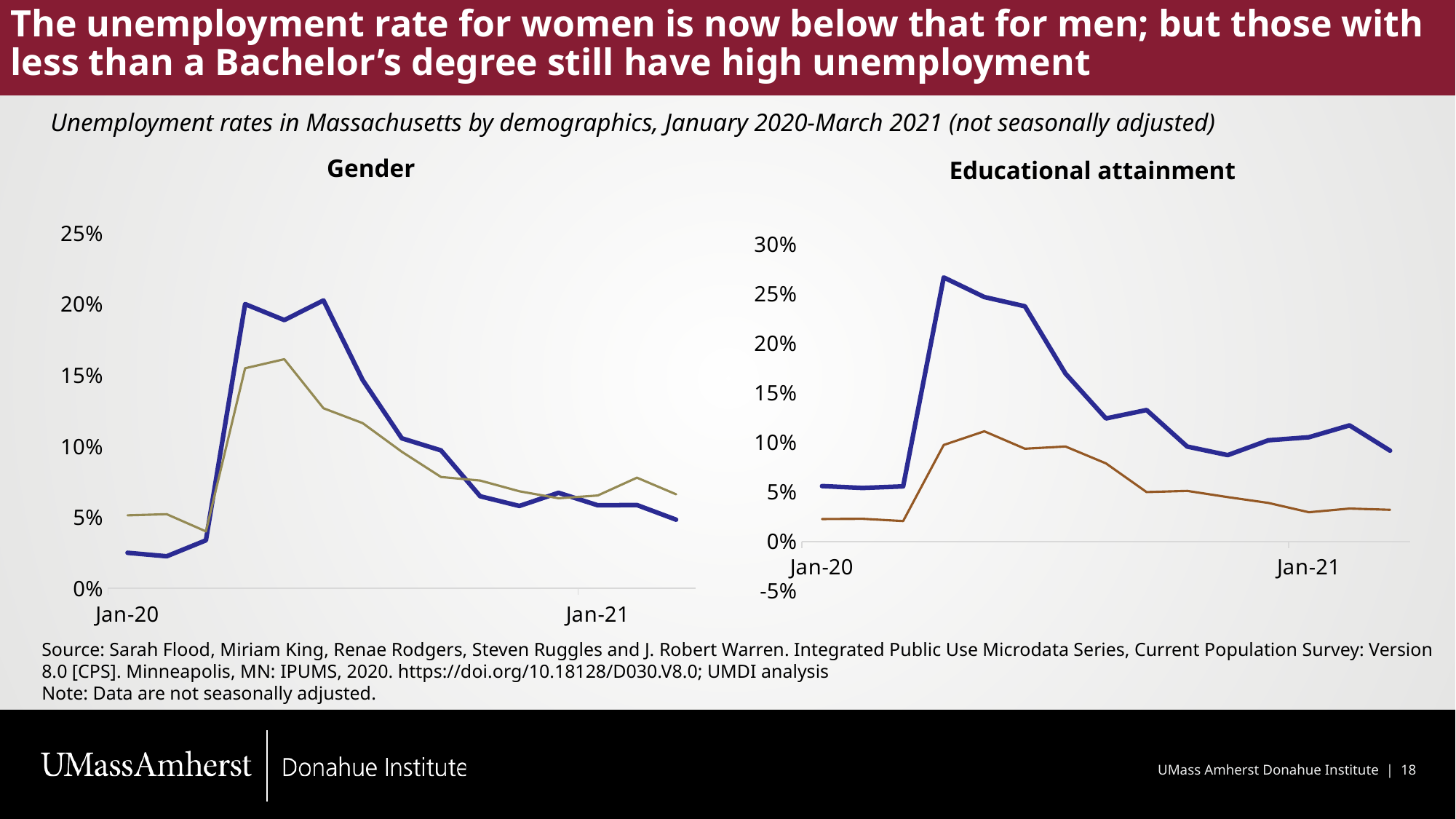
In the Gender chart, is the peak value of the dark blue line greater or less than 15%? greater What is the highest value shown on the y axis of the Educational attainment chart? 30% In the Gender chart, is the peak value of the tan line greater or less than 20%? less In the Educational attainment chart, is the peak value of the brown line greater or less than 15%? less In the Gender chart, which line reaches a higher peak, the dark blue line or the tan line? the dark blue line How many charts are shown on the slide? 2 In the Educational attainment chart, does the dark blue line rise or fall between its spring 2020 peak and Jan-21? fall What kind of chart is the Educational attainment chart? line chart In the Educational attainment chart, which line reaches a higher peak, the dark blue line or the brown line? the dark blue line What kind of chart is the Gender chart? line chart